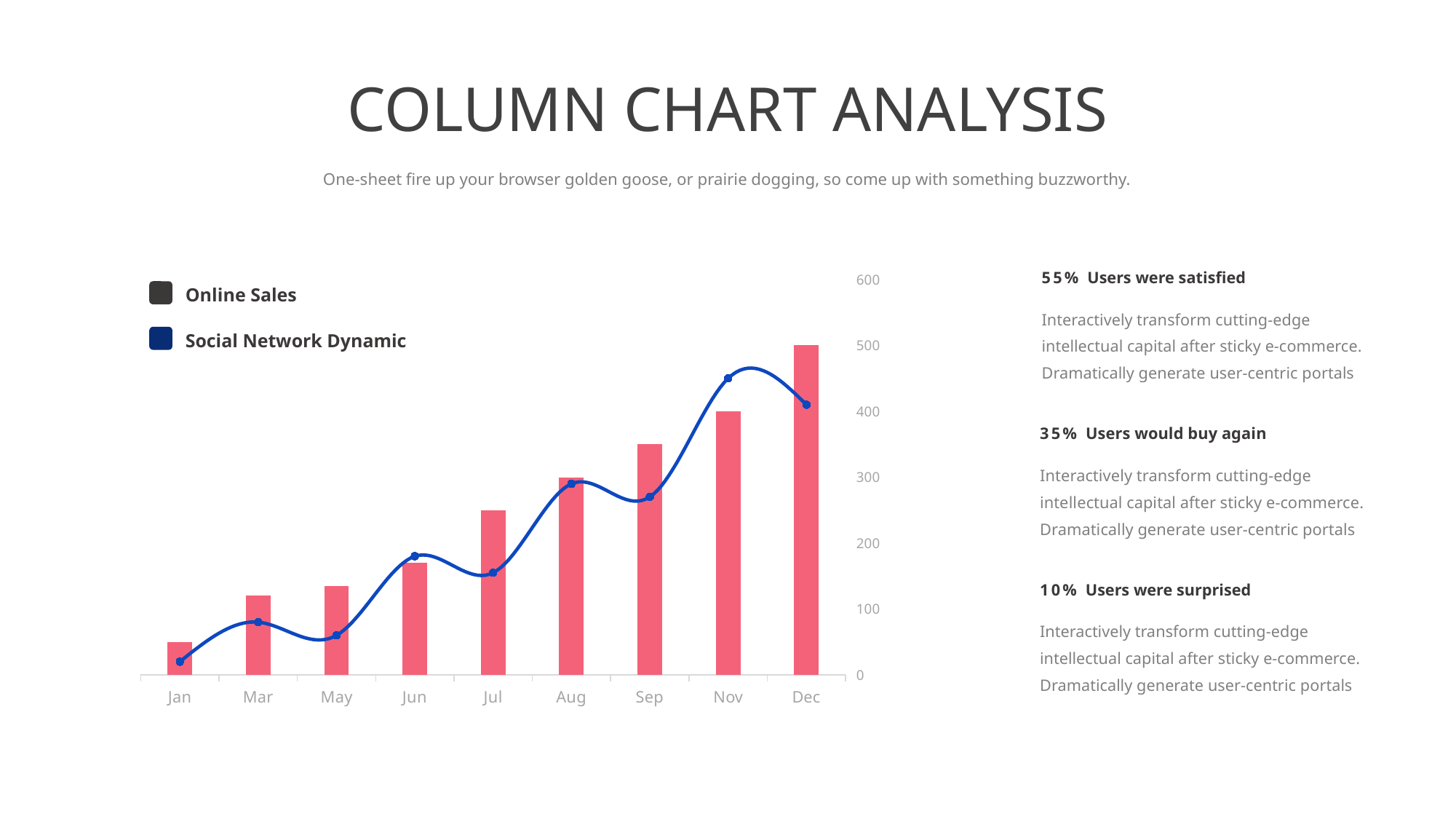
Is the Social Network Dynamic value for Nov greater or less than 400? greater How many categories are shown on the x axis of the chart? 9 Which month has the highest Online Sales bar? Dec Which month has the lowest Online Sales bar? Jan Do the Online Sales bars generally rise or fall from Jan to Dec? rise What colour is used for the Social Network Dynamic series in the legend? Blue How many series does the chart legend list? 2 Which is larger, the Online Sales bar for Jul or for Mar? Jul In which month does the Social Network Dynamic line reach its highest point? Nov Is the Online Sales value for Dec greater or less than 400? greater Is the Online Sales value for Jan greater or less than 100? less What kind of chart is shown on the slide? A bar chart combined with a line